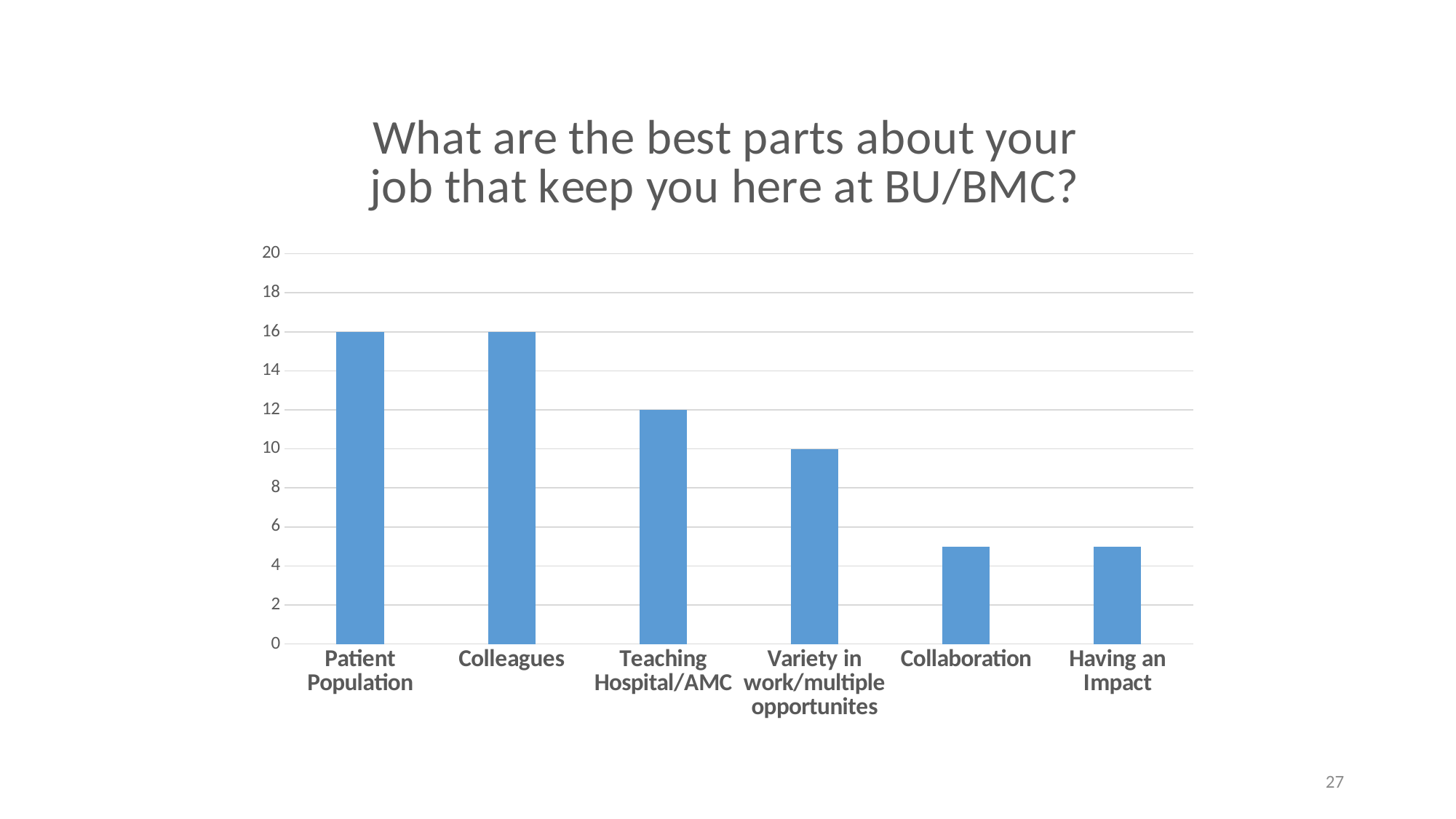
What is the difference between the value for Teaching Hospital/AMC and the value for Variety in work/multiple opportunites? 2 What value does the bar for Patient Population reach? 16 What kind of chart is shown on the slide? bar chart What value does the bar for Colleagues reach? 16 How many categories are shown on the x axis? 6 What is the difference between the value for Patient Population and the value for Teaching Hospital/AMC? 4 What value does the bar for Teaching Hospital/AMC reach? 12 Which is larger, the value for Teaching Hospital/AMC or the value for Variety in work/multiple opportunites? Teaching Hospital/AMC Do the values generally rise or fall moving from left to right along the x axis? fall What value does the bar for Variety in work/multiple opportunites reach? 10 Is the value for Collaboration greater or less than 4? greater Is the value for Having an Impact greater or less than 6? less